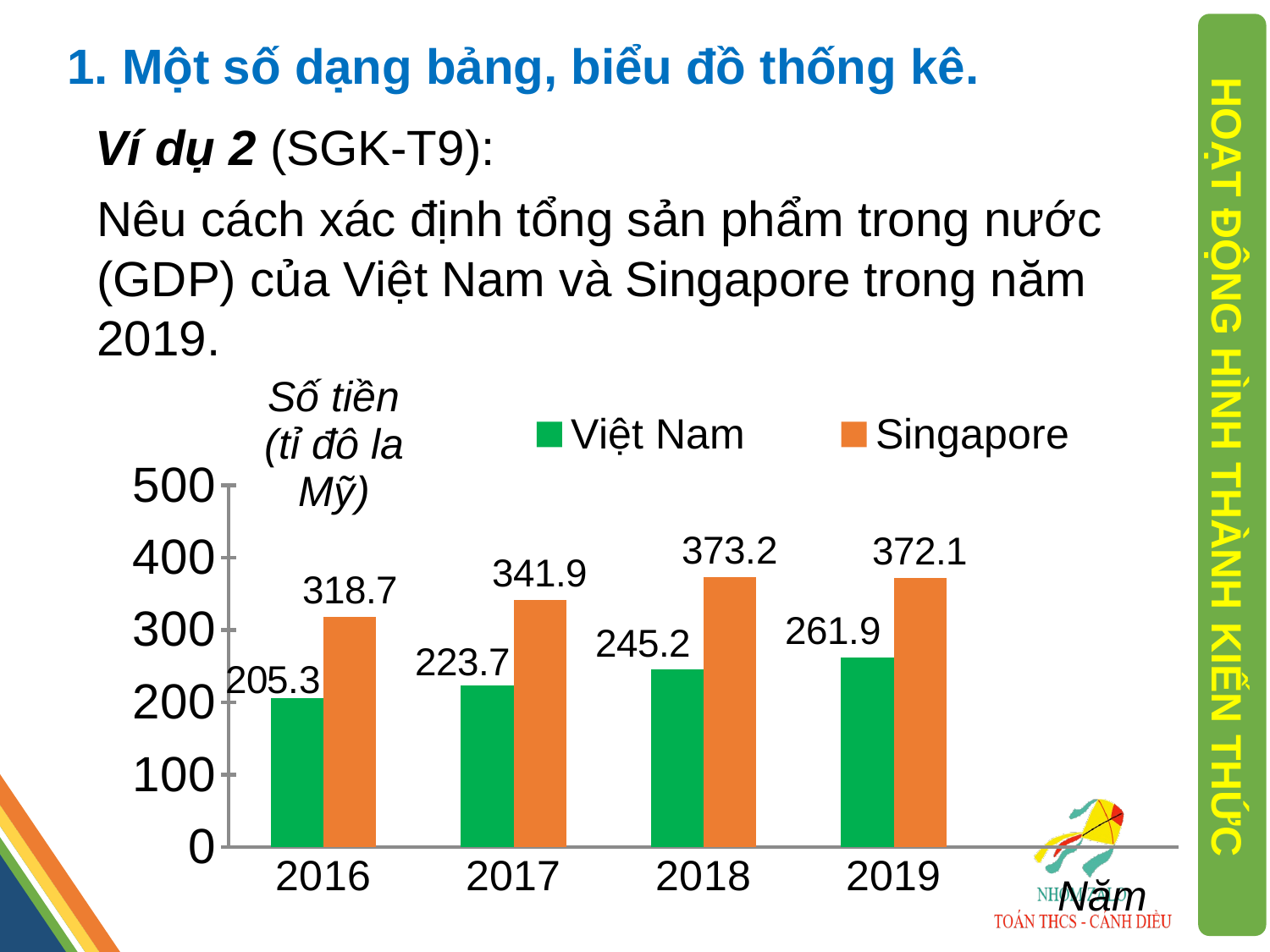
What is the difference between the Singapore and Việt Nam values in 2019? 110.2 Is the value for Singapore in 2018 greater or less than 300? greater What kind of chart is shown on the slide? bar chart What is the difference between the Việt Nam values in 2017 and 2016? 18.4 How many years are shown on the x axis? 4 Which is larger in 2017, the Việt Nam value or the Singapore value? Singapore In which year is the Việt Nam value the lowest? 2016 What is the GDP value for Singapore in 2016? 318.7 What is the GDP value for Việt Nam in 2019? 261.9 How many series does the legend list? 2 In which year is the Việt Nam value the highest? 2019 What is the GDP value for Singapore in 2018? 373.2